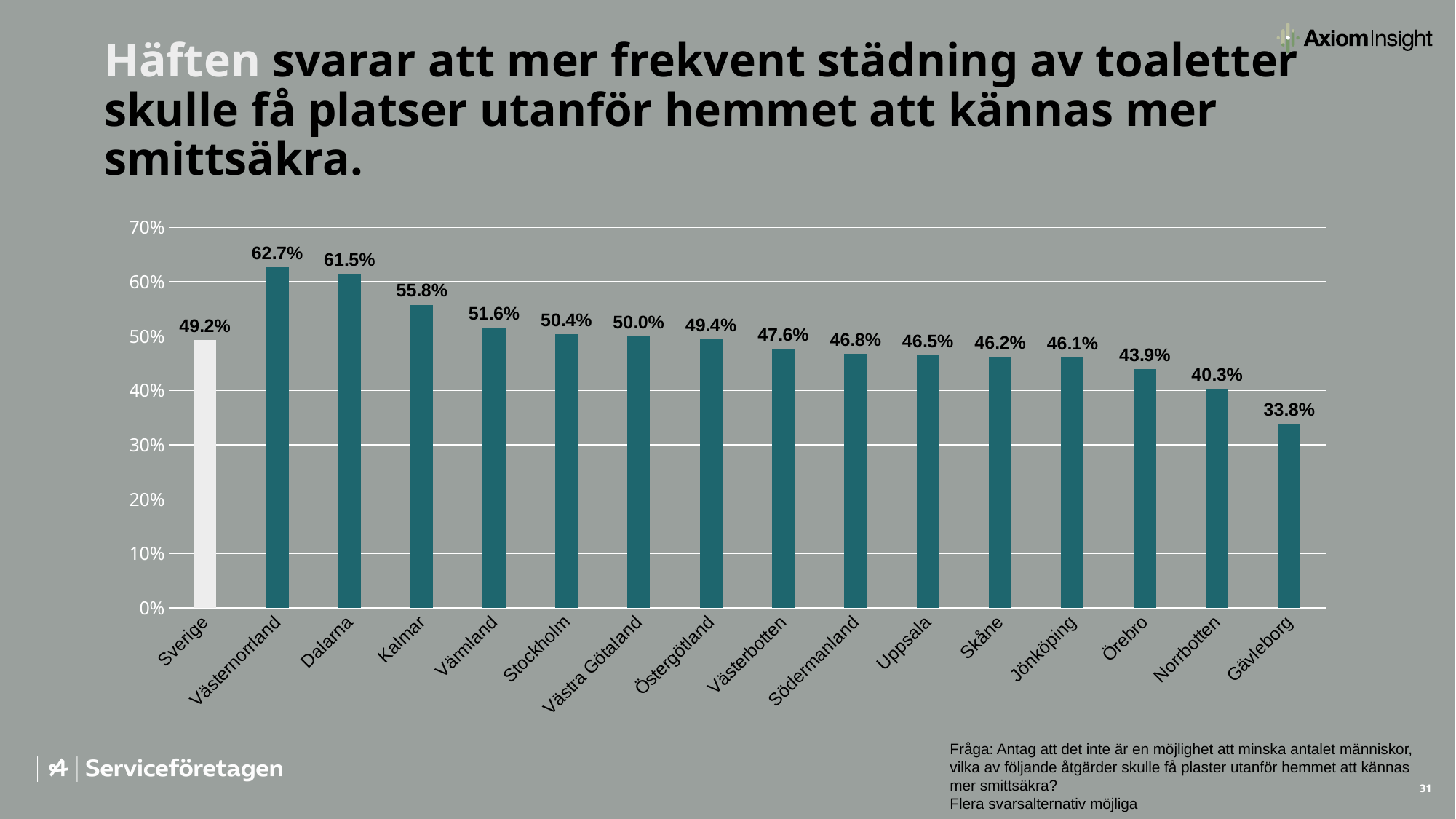
Do the values rise or fall from Västernorrland to Gävleborg along the x axis? fall What is the value for Norrbotten? 40.3% What kind of chart is shown on the slide? bar chart How many categories are shown on the x axis? 16 What is the value for Kalmar? 55.8% Which region has the highest value? Västernorrland Which is larger, the value for Dalarna or the value for Värmland? Dalarna Which region has the lowest value? Gävleborg What is the value for Sverige? 49.2% What is the difference between Västernorrland and Gävleborg? 28.9% Is the value for Örebro greater or less than 40%? greater Which bar is shown in a different colour from the others? Sverige